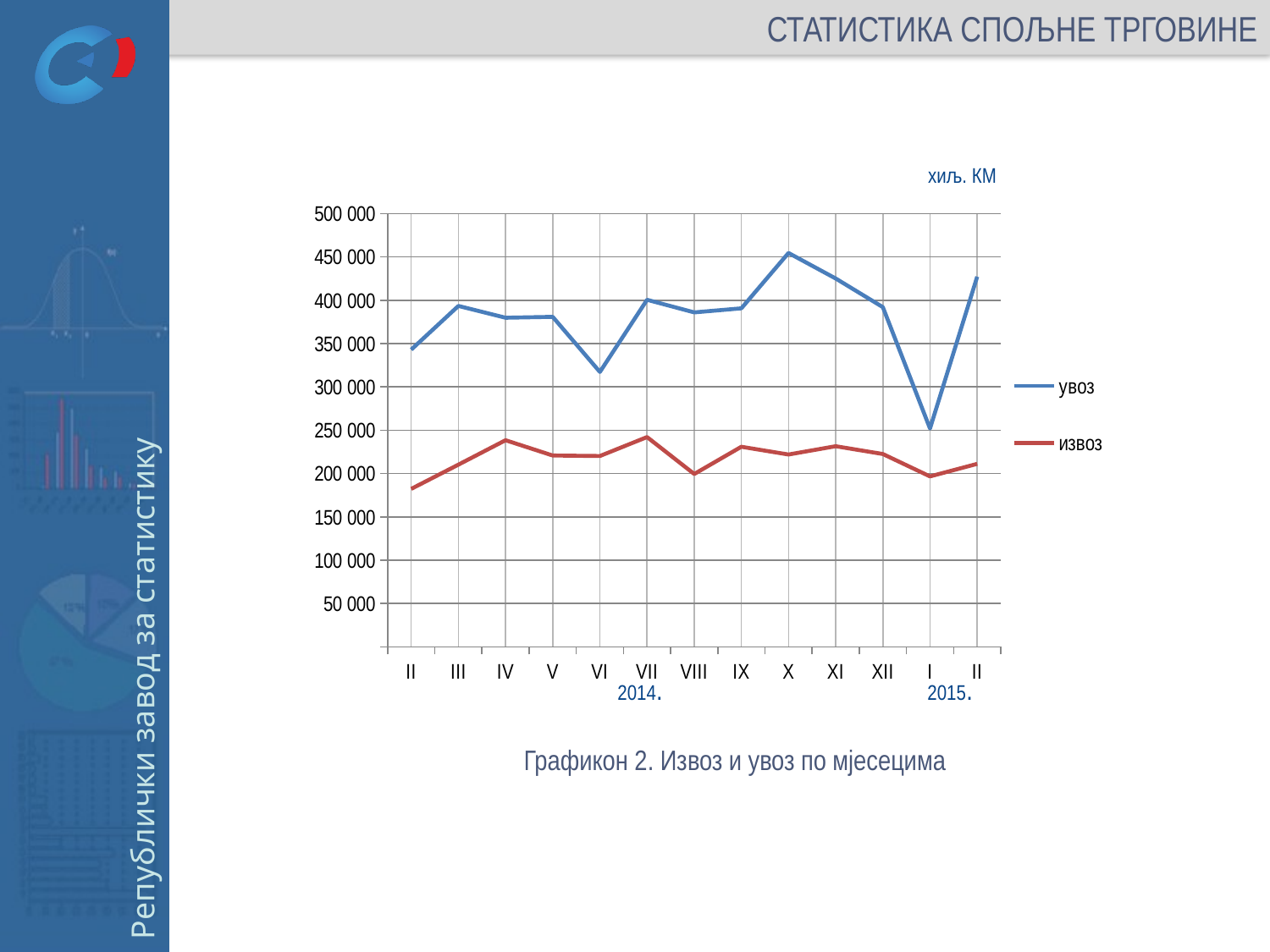
Is the value for увоз in X 2014 greater or less than 450 000? greater Which series has the larger value in VI 2014, увоз or извоз? увоз In which month is the value for извоз lowest? II 2014 In which month is the value for увоз lowest? I 2015 How many series does the legend list? 2 In which month is the value for увоз highest? X 2014 What kind of chart is shown on the slide? line chart What unit is shown above the chart? хиљ. КМ Is the value for извоз in VII 2014 greater or less than 200 000? greater Does the увоз line rise or fall between XII 2014 and I 2015? fall Is the value for увоз in I 2015 greater or less than 300 000? less How many months are plotted along the x axis? 13